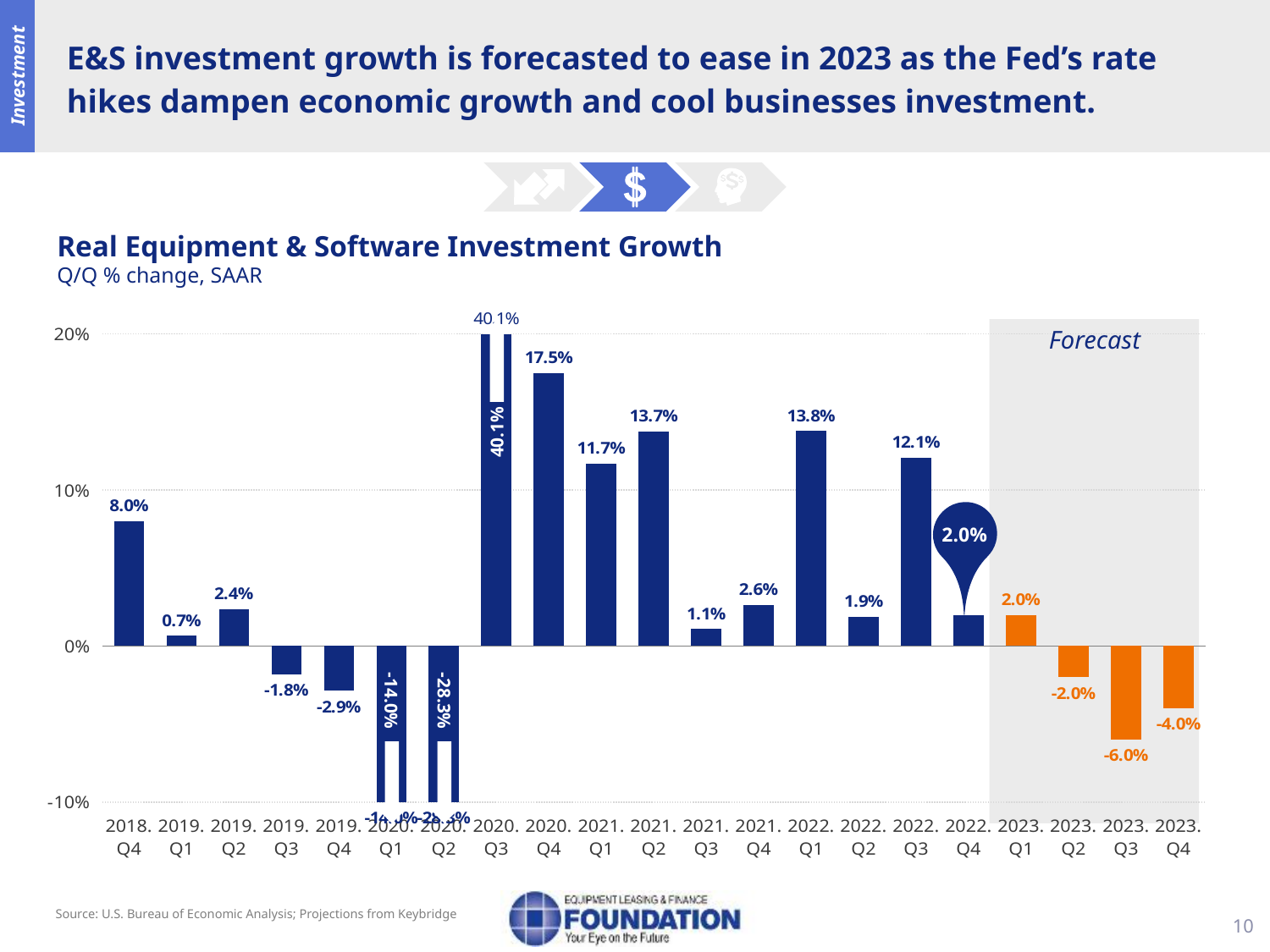
Which is larger, the value for 2022 Q3 or the value for 2022 Q4? 2022 Q3 What is the value for 2020 Q3? 40.1% How many quarters are shown in the shaded Forecast area? 4 Is the value for 2018 Q4 greater or less than 10%? less How many quarters are plotted on the chart? 21 What is the difference between the values for 2020 Q4 and 2021 Q1? 5.8 percentage points What is the subtitle under the chart title? Q/Q % change, SAAR Which quarter has the highest value? 2020 Q3 What is the value for 2020 Q2? -28.3% What is the forecast value for 2023 Q3? -6.0% What type of chart is shown on the slide? Bar chart Which quarter has the lowest value? 2020 Q2